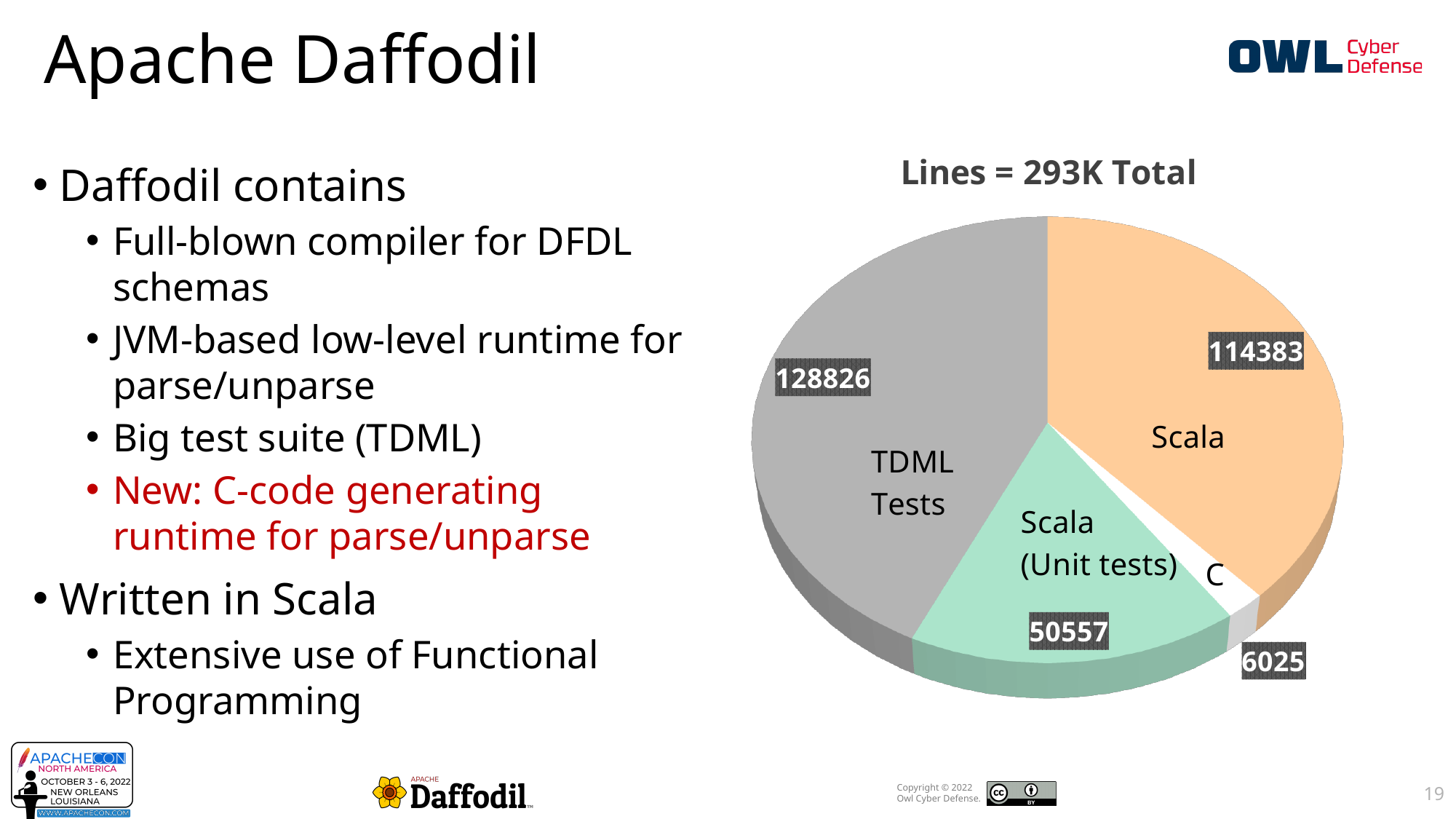
How many lines are shown for Scala (Unit tests)? 50557 How many lines are shown for TDML Tests? 128826 How many lines are shown for Scala? 114383 What is the title of the pie chart? Lines = 293K Total Which slice of the pie chart is the largest? TDML Tests What is the difference in lines between Scala (Unit tests) and C? 44532 What kind of chart is shown on the slide? pie chart Which slice of the pie chart is the smallest? C What is the difference in lines between TDML Tests and Scala? 14443 How many lines are shown for C? 6025 How many slices does the pie chart have? 4 Which has more lines, TDML Tests or Scala? TDML Tests